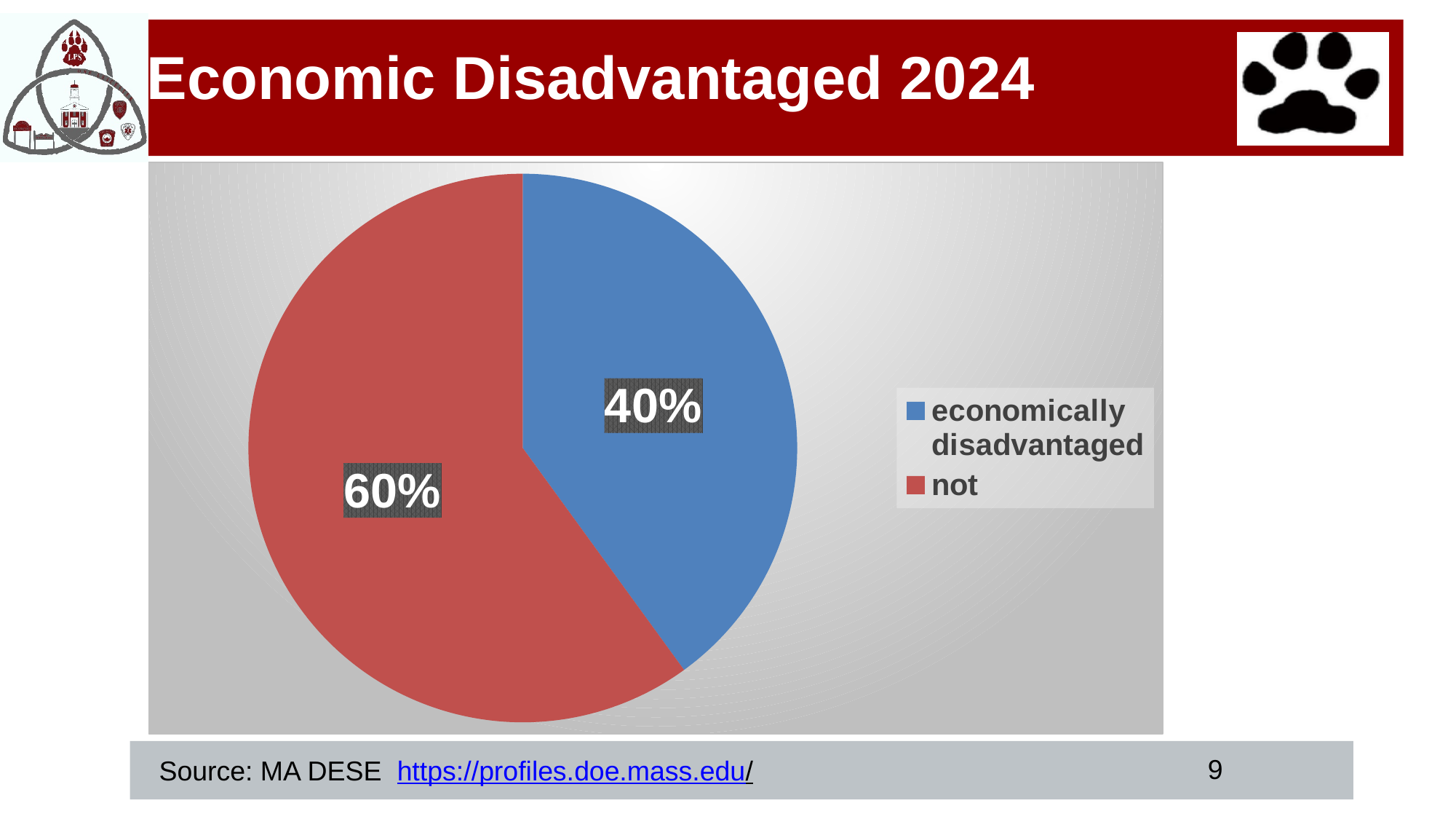
What share of the pie is labelled "not"? 60% What kind of chart is shown on the slide? pie chart How many entries does the legend list? 2 What is the difference in percentage points between the "not" slice and the "economically disadvantaged" slice? 20% Which slice of the pie is the smallest? economically disadvantaged Which is larger, the "economically disadvantaged" slice or the "not" slice? not Which slice of the pie is the largest? not What colour is the "economically disadvantaged" slice? blue What is the title of the slide containing the chart? Economic Disadvantaged 2024 How many slices does the pie chart have? 2 What share of the pie is labelled "economically disadvantaged"? 40%